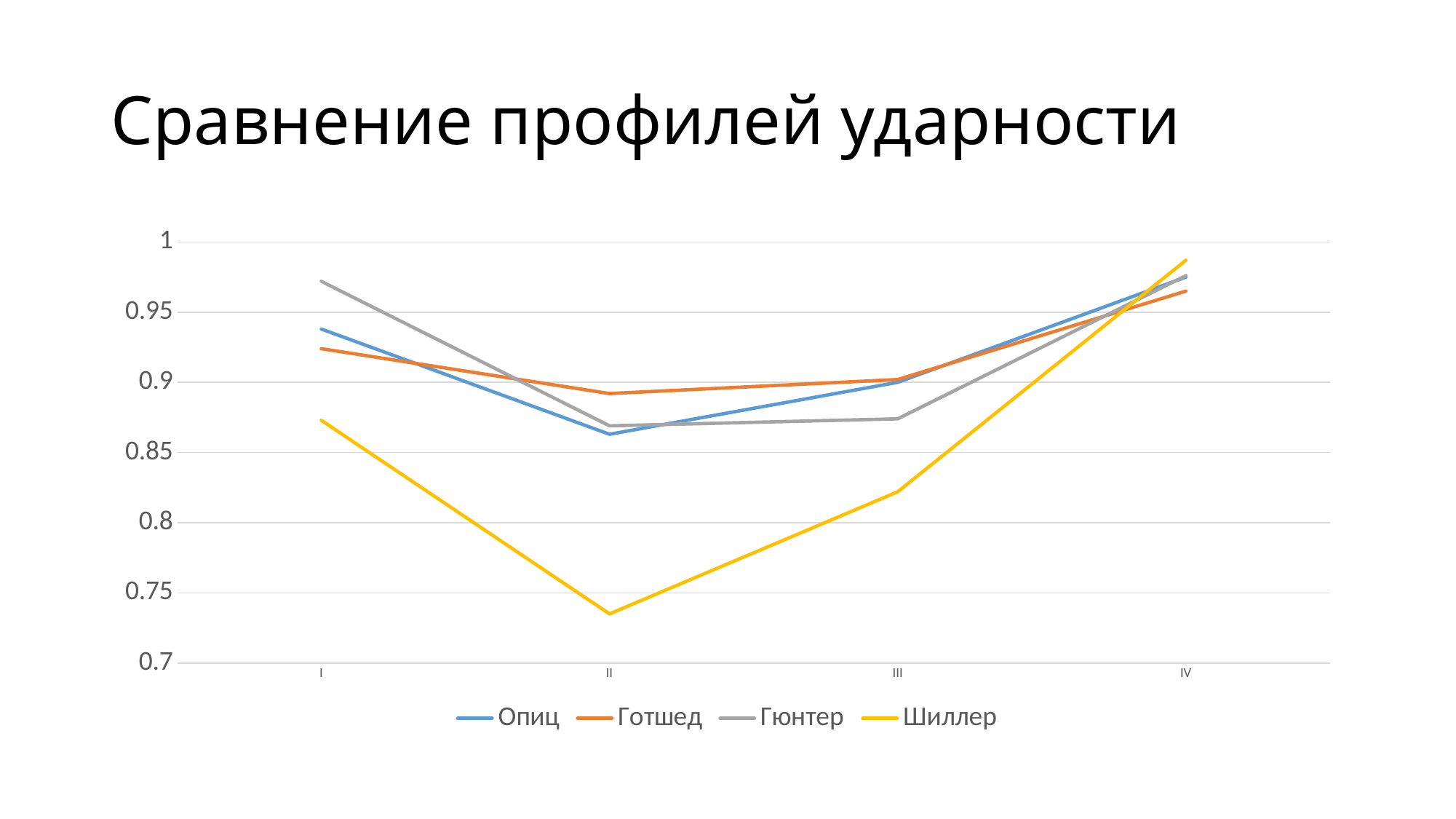
Is the value for Шиллер at category II greater or less than 0.75? less What is the title of the chart? Сравнение профилей ударности Which series is drawn in yellow? Шиллер Which series has the lowest value at category II? Шиллер What kind of chart is shown on the slide? line chart Is the value for Шиллер at category III greater or less than 0.8? greater How many series does the legend list? 4 Which series has the highest value at category I? Гюнтер At which category does the Шиллер series reach its lowest value? II Is the value for Гюнтер at category I greater or less than 0.95? greater Which is larger at category III, the value for Опиц or the value for Шиллер? Опиц How many categories are on the x axis? 4